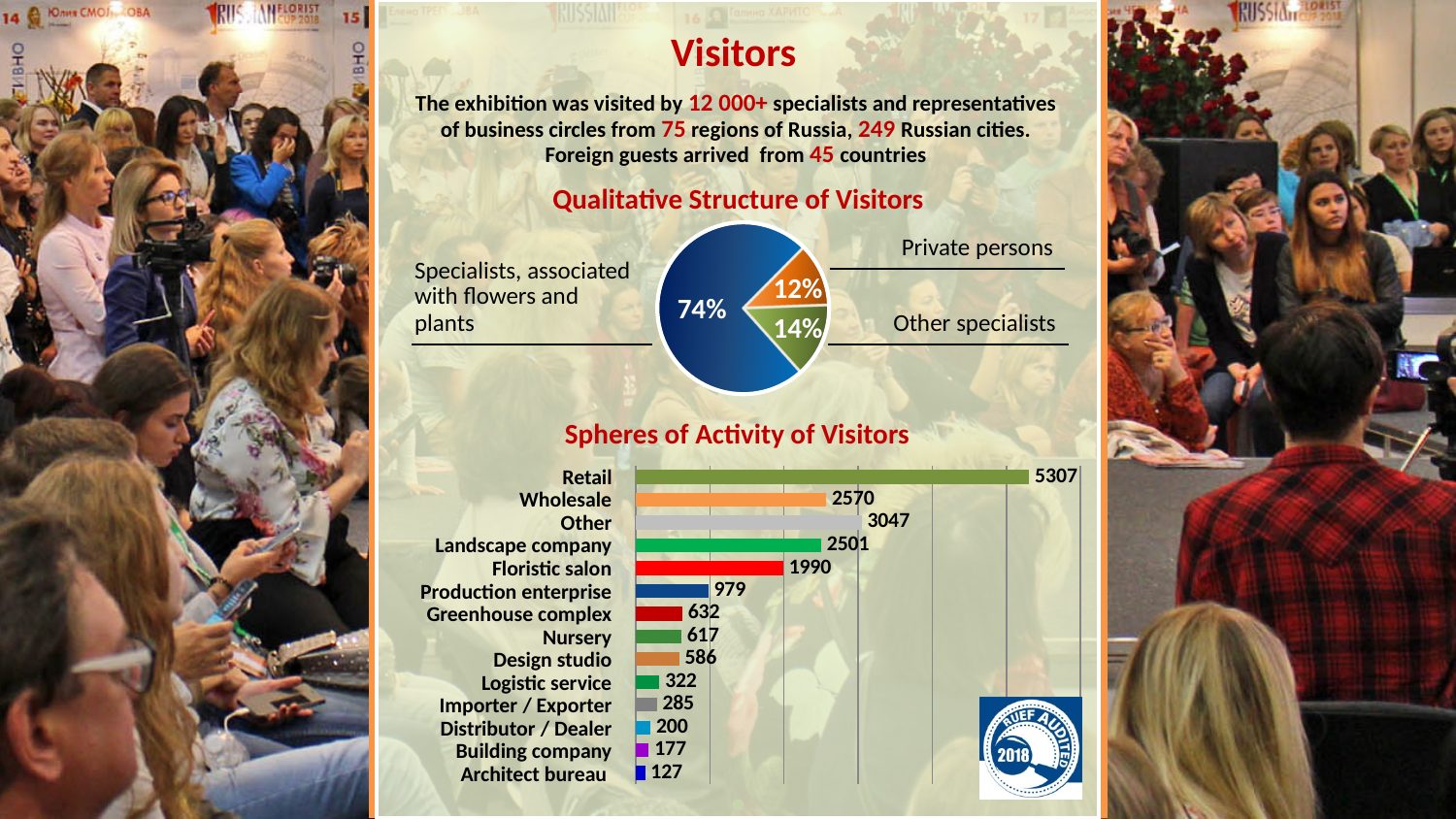
In the Qualitative Structure of Visitors pie chart, which group has the smallest share? Private persons In the Spheres of Activity of Visitors chart, what is the value for Floristic salon? 1990 In the Qualitative Structure of Visitors pie chart, what share of visitors are private persons? 12% In the Spheres of Activity of Visitors chart, what is the value for Logistic service? 322 How many categories are shown in the Spheres of Activity of Visitors chart? 14 In the Spheres of Activity of Visitors chart, which category has the highest value? Retail In the Qualitative Structure of Visitors pie chart, what share of visitors are specialists associated with flowers and plants? 74% In the Spheres of Activity of Visitors chart, which is larger, Greenhouse complex or Nursery? Greenhouse complex What kind of chart is the Spheres of Activity of Visitors chart? Bar chart In the Spheres of Activity of Visitors chart, what is the difference between Other and Wholesale? 477 In the Spheres of Activity of Visitors chart, which category has the lowest value? Architect bureau In the Spheres of Activity of Visitors chart, what is the value for Retail? 5307